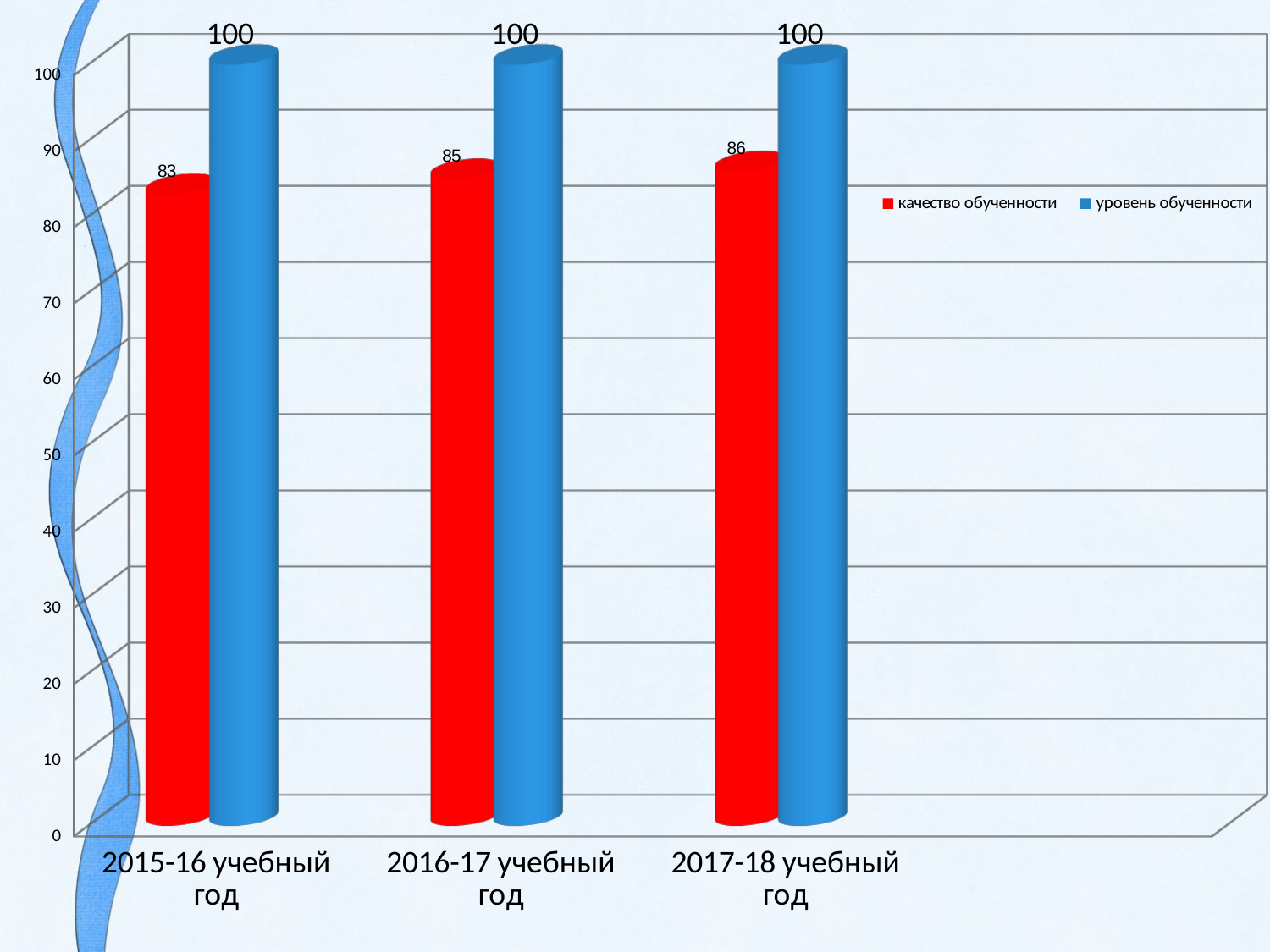
How many series does the legend list? 2 Does качество обученности rise or fall across the school years from 2015-16 to 2017-18? rise How many school years are shown on the x axis? 3 In which school year is качество обученности highest? 2017-18 учебный год What is the difference between уровень обученности and качество обученности in 2015-16 учебный год? 17 What is the value of качество обученности for 2016-17 учебный год? 85 Which is larger in 2016-17 учебный год: качество обученности or уровень обученности? уровень обученности By how much did качество обученности increase from 2015-16 to 2017-18 учебный год? 3 What is the value of уровень обученности for 2017-18 учебный год? 100 In which school year is качество обученности lowest? 2015-16 учебный год What is the value of качество обученности for 2015-16 учебный год? 83 What is the value of качество обученности for 2017-18 учебный год? 86